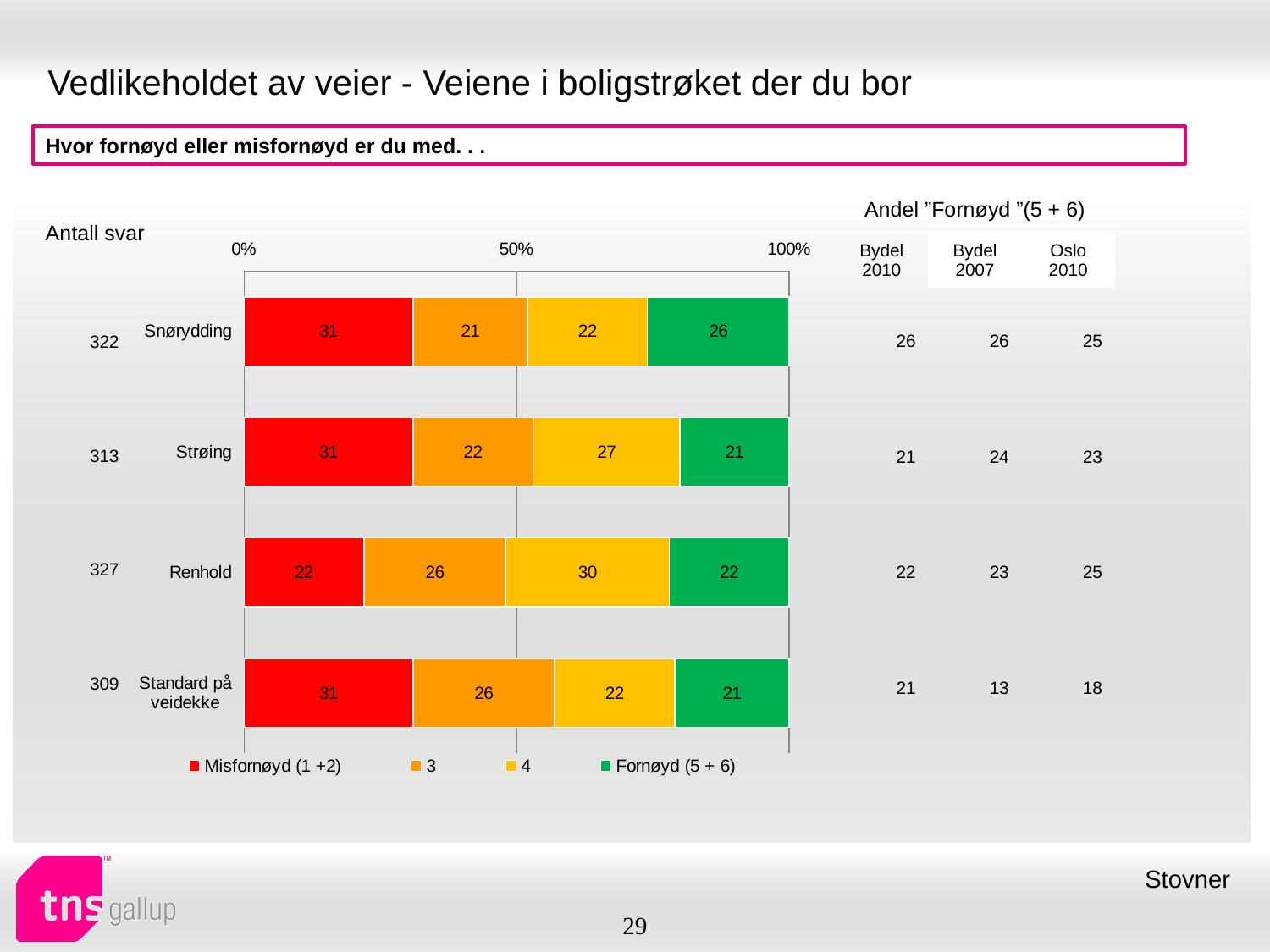
What is the value of the Fornøyd (5 + 6) segment for Strøing? 21 How many series does the legend of the bar chart list? 4 Which category has the lowest Misfornøyd (1 +2) value? Renhold What is the difference between the '4' segment for Renhold and the '4' segment for Snørydding? 8 Which is larger: the Fornøyd (5 + 6) value for Snørydding or for Renhold? Snørydding Which category has the highest Fornøyd (5 + 6) value? Snørydding What is the value of the '4' segment for Renhold? 30 What kind of chart is shown on the slide? stacked bar chart How many categories are plotted in the bar chart? 4 What is the value of the '3' segment for Standard på veidekke? 26 What is the value of the Misfornøyd (1 +2) segment for Snørydding? 31 Which colour represents the Fornøyd (5 + 6) series in the bar chart? green